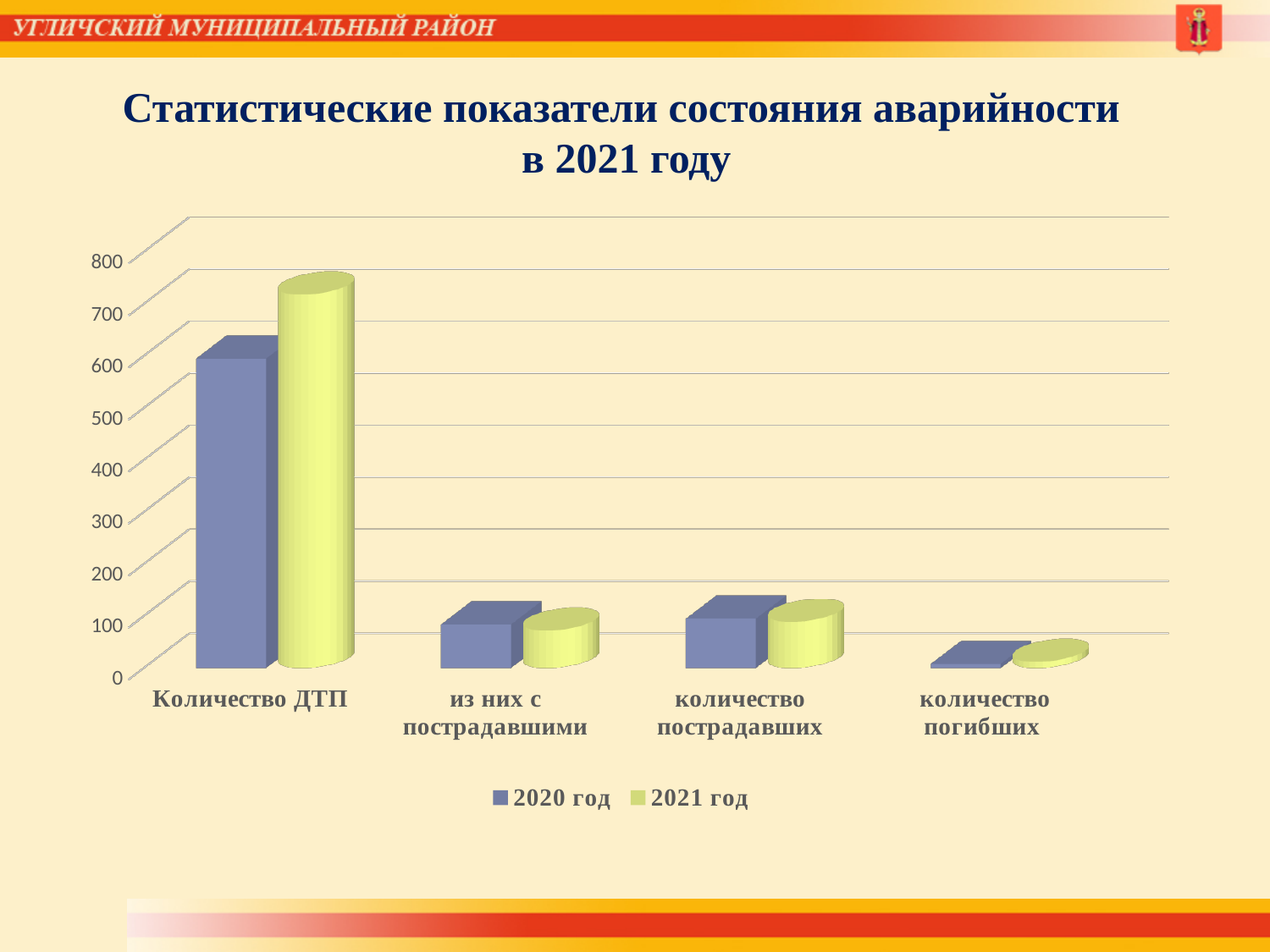
Is the value for из них с пострадавшими in 2020 год greater or less than 200? less For Количество ДТП, which series has the larger value, 2020 год or 2021 год? 2021 год Which category has the lowest values in the chart? количество погибших Is the value for Количество ДТП in 2020 год greater or less than 500? greater Is the value for количество погибших in 2021 год greater or less than 100? less How many series does the chart legend list? 2 What are the two entries listed in the chart legend? 2020 год and 2021 год Which category has the highest values in the chart? Количество ДТП What kind of chart is shown on the slide? bar chart How many categories are shown on the x axis of the chart? 4